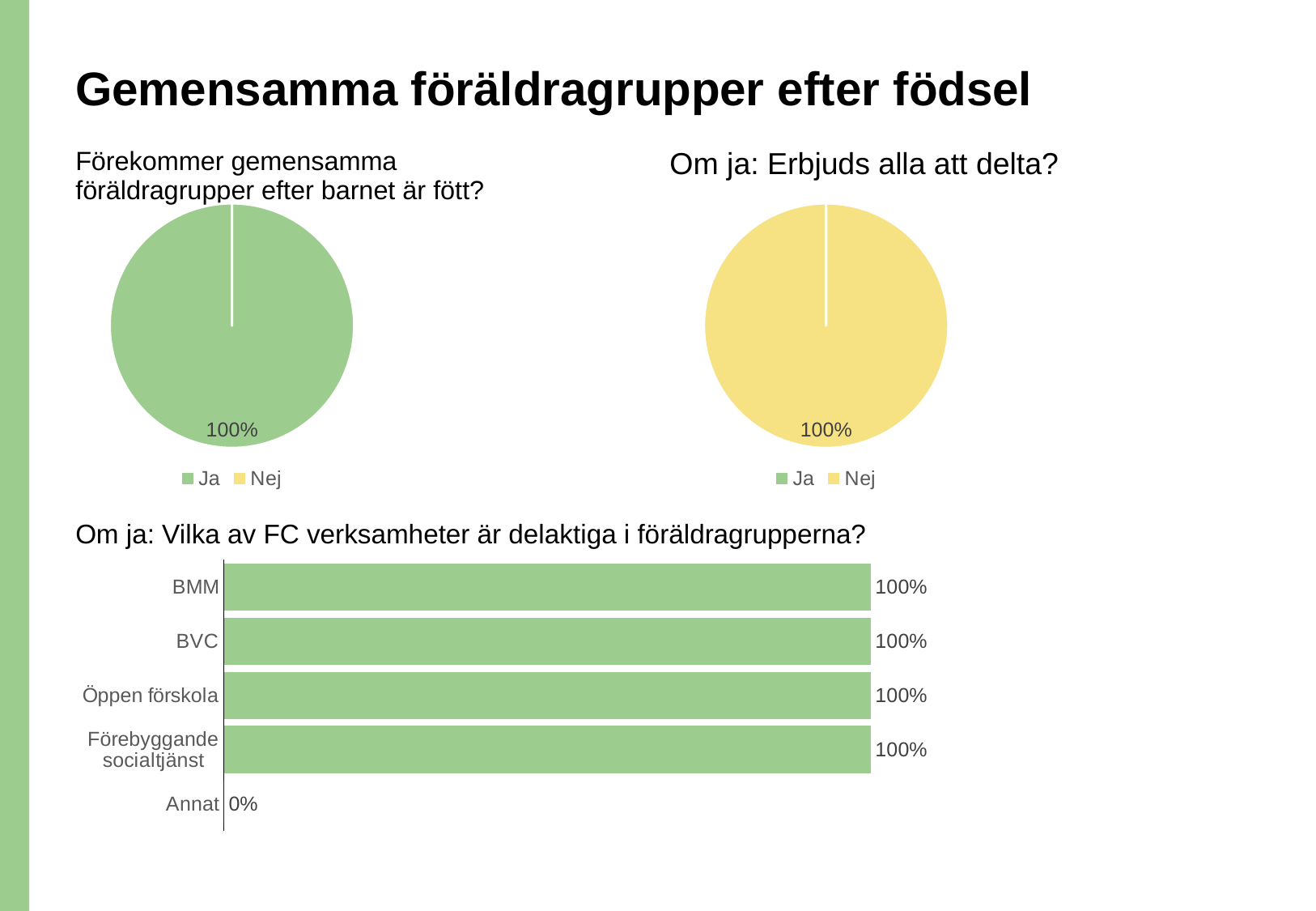
In the bar chart at the bottom of the slide, which category has the lowest value? Annat In the bar chart at the bottom of the slide, what is the difference between the values for BVC and Annat? 100% In the bar chart titled "Om ja: Vilka av FC verksamheter är delaktiga i föräldragrupperna?", what is the value for Förebyggande socialtjänst? 100% In the bar chart at the bottom of the slide, how many categories are shown? 5 In the bar chart titled "Om ja: Vilka av FC verksamheter är delaktiga i föräldragrupperna?", what is the value for Annat? 0% In the bar chart at the bottom of the slide, which is larger, the value for Öppen förskola or the value for Annat? Öppen förskola What kind of chart is shown at the bottom of the slide under "Om ja: Vilka av FC verksamheter är delaktiga i föräldragrupperna?"? Bar chart What kind of chart is shown under the title "Förekommer gemensamma föräldragrupper efter barnet är fött?"? Pie chart In the pie chart titled "Om ja: Erbjuds alla att delta?", what share does Nej have? 100% How many entries does the legend of the pie chart titled "Om ja: Erbjuds alla att delta?" list? 2 In the bar chart titled "Om ja: Vilka av FC verksamheter är delaktiga i föräldragrupperna?", what is the value for BMM? 100% In the pie chart titled "Förekommer gemensamma föräldragrupper efter barnet är fött?", what share does Ja have? 100%